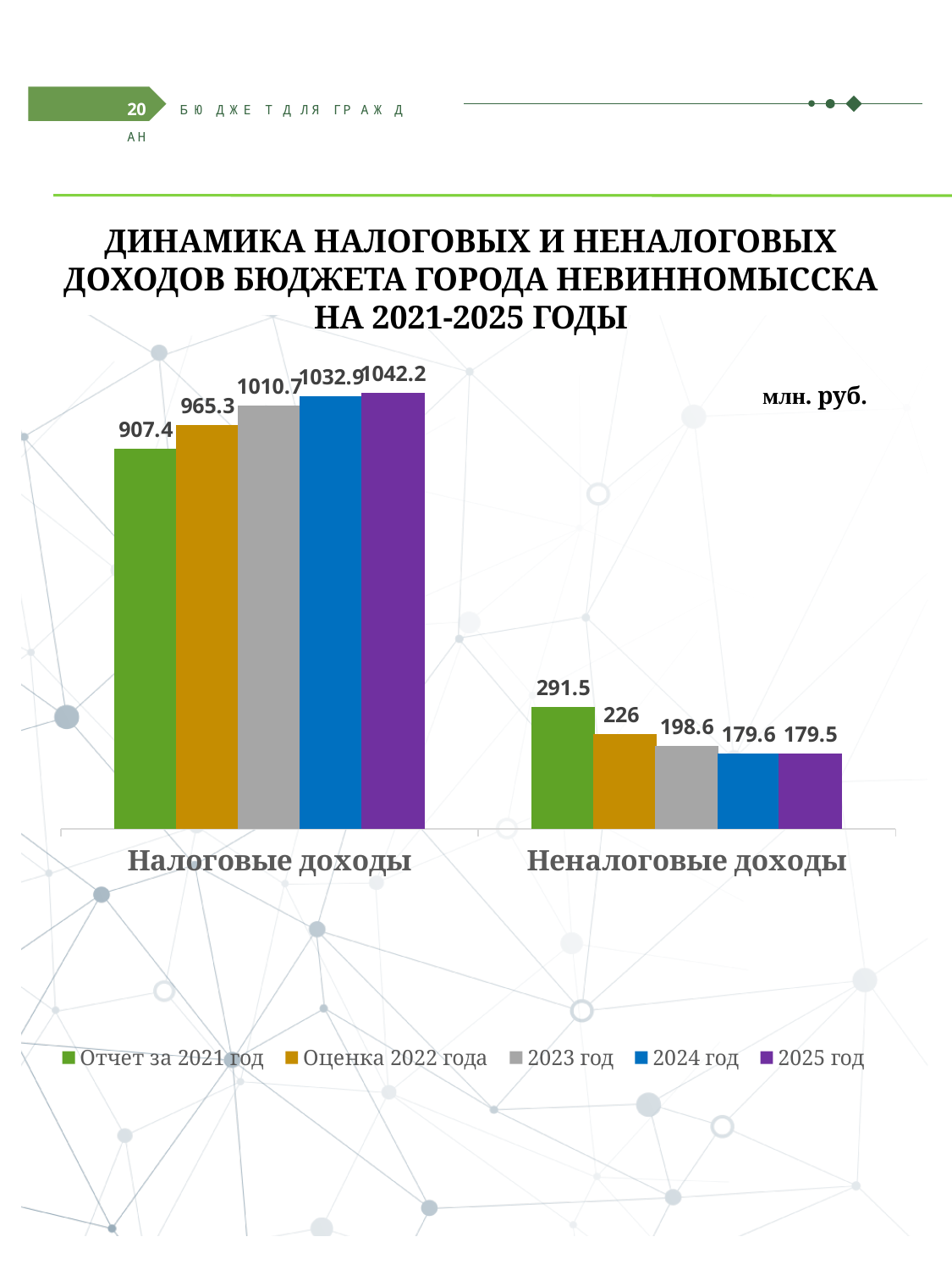
Which series has the highest value for Налоговые доходы? 2025 год How many categories are shown on the x axis? 2 What is the value for Неналоговые доходы in the series 2025 год? 179.5 What is the difference between the Налоговые доходы values for 2025 год and Отчет за 2021 год? 134.8 Which series has the lowest value for Неналоговые доходы? 2025 год Which is larger: Неналоговые доходы for Отчет за 2021 год or for Оценка 2022 года? Отчет за 2021 год What is the value for Неналоговые доходы in the series 2023 год? 198.6 How many series does the legend list? 5 Do the Неналоговые доходы values rise or fall from Отчет за 2021 год to 2025 год? Fall What is the value for Налоговые доходы in the series Оценка 2022 года? 965.3 What is the value for Налоговые доходы in the series Отчет за 2021 год? 907.4 What kind of chart is shown on the slide? Bar chart